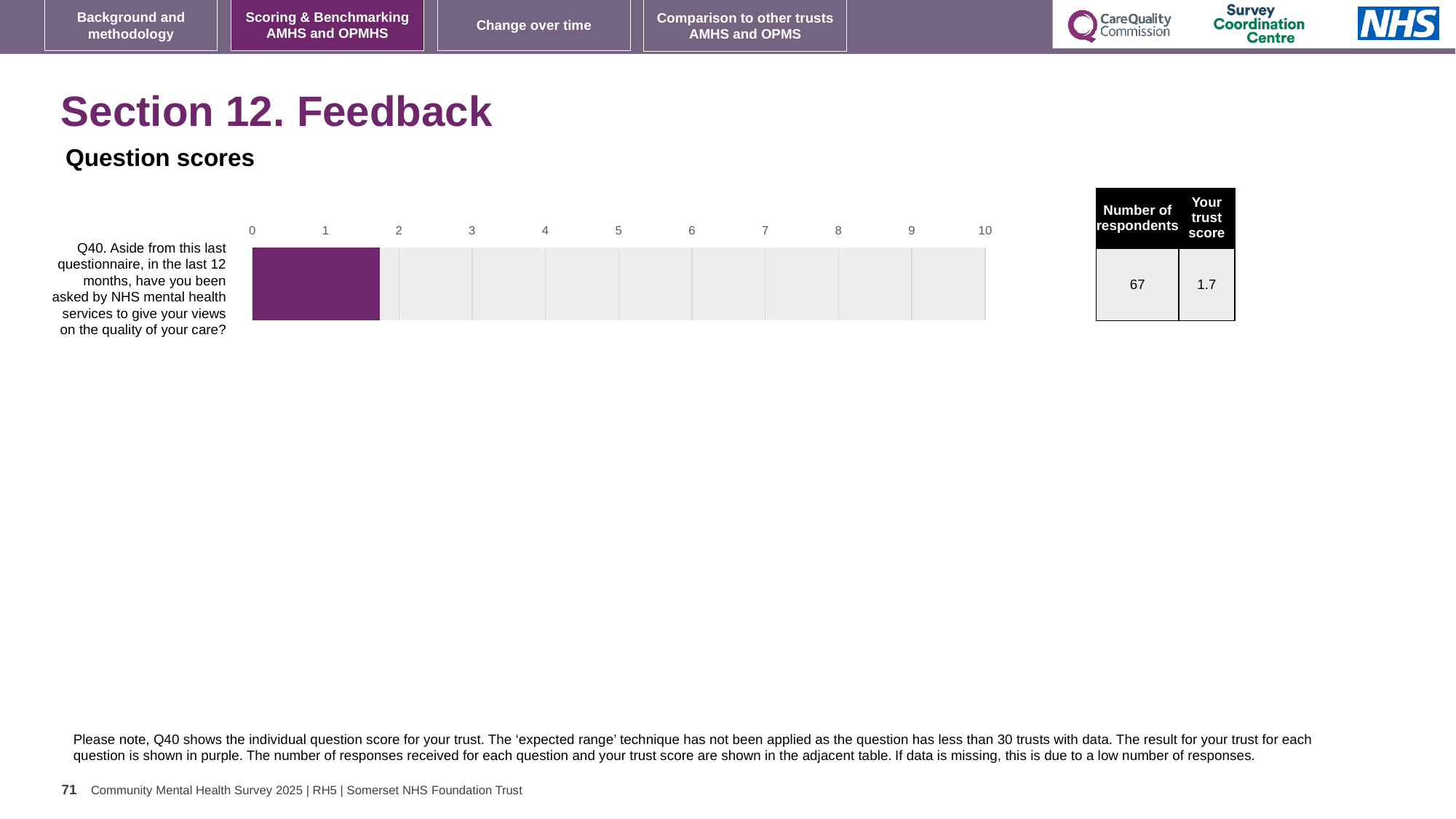
Which question number is plotted on the chart? Q40 What colour is the bar representing the trust's score for Q40? purple Is the value for Q40 greater or less than 1? greater Is the value for Q40 greater or less than 2? less How many questions (bars) are plotted on the chart? 1 Is the value for Q40 greater or less than 5? less What is the maximum value shown on the chart's axis? 10 What kind of chart is used to show the Q40 score? bar chart How many respondents answered Q40 according to the table? 67 What is the trust score for Q40 shown on the slide? 1.7